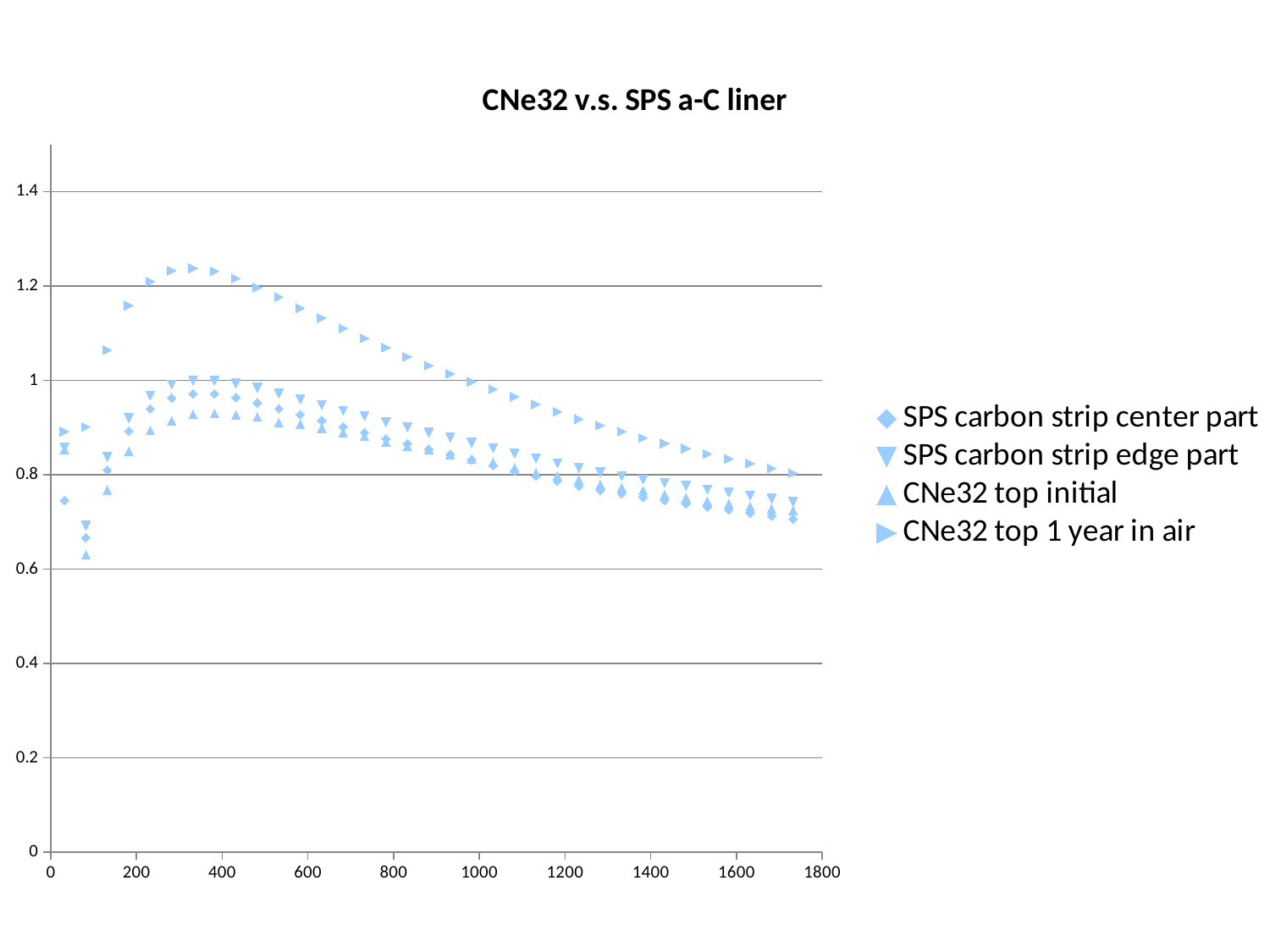
Do the values for CNe32 top 1 year in air rise or fall as x increases from 0 to 300? rise Is the value for CNe32 top 1 year in air at x = 400 greater or less than 1.2? greater Is the value for CNe32 top initial at x = 80 greater or less than 0.8? less Is the value for SPS carbon strip center part at x = 1600 greater or less than 0.8? less What is the highest tick value shown on the x axis? 1800 Do the values for CNe32 top 1 year in air rise or fall as x increases from 400 to 1800? fall What is the title of the chart? CNe32 v.s. SPS a-C liner At x = 1000, which series has the higher value: CNe32 top 1 year in air or SPS carbon strip edge part? CNe32 top 1 year in air What kind of chart is shown on the slide? scatter chart Which series reaches the highest value on the chart? CNe32 top 1 year in air How many series does the legend list? 4